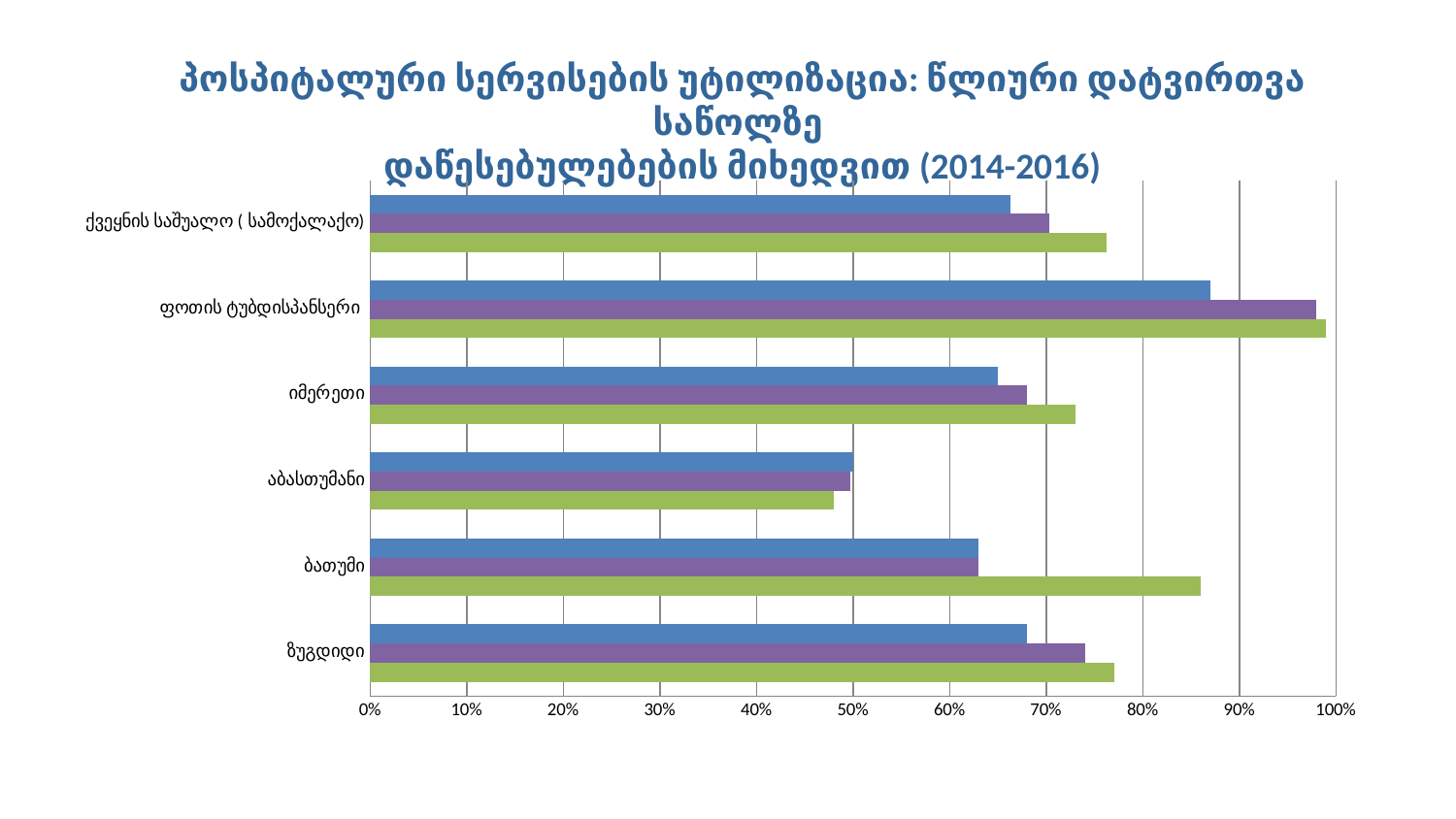
Is the green bar for ფოთის ტუბდისპანსერი greater or less than 90%? greater Which category has the longer blue bar, ფოთის ტუბდისპანსერი or ბათუმი? ფოთის ტუბდისპანსერი Is the green bar for აბასთუმანი greater or less than 50%? less Which category has the shortest green bar in the chart? აბასთუმანი Which years are given in parentheses in the chart title? 2014-2016 Is the blue bar for ზუგდიდი greater or less than 60%? greater Which category has the longer green bar, ბათუმი or ზუგდიდი? ბათუმი What kind of chart is shown on the slide? bar chart How many categories are listed on the vertical axis of the chart? 6 How many bars are plotted for each category in the chart? 3 Which category has the longest green bar in the chart? ფოთის ტუბდისპანსერი